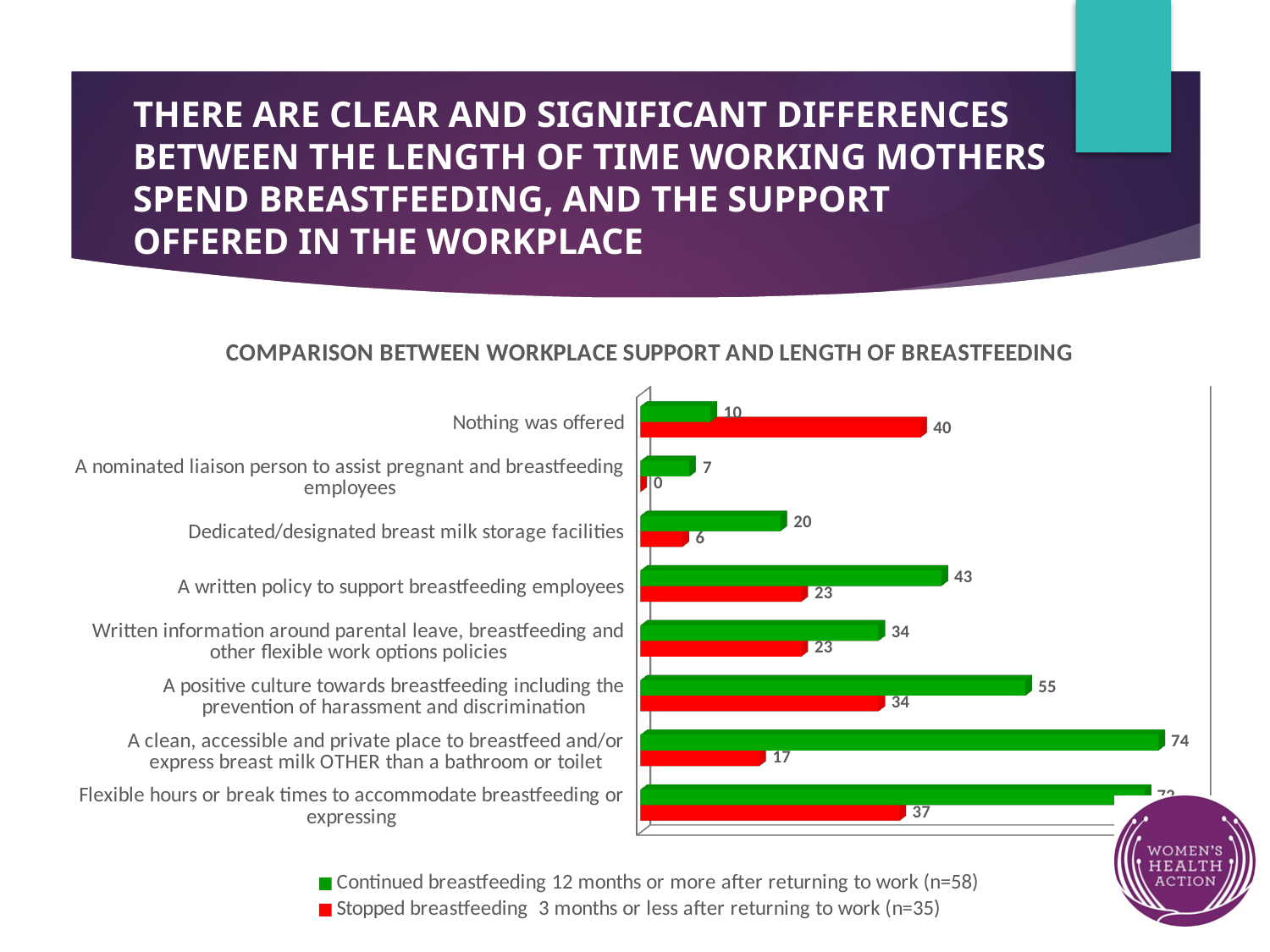
Which category has the highest value in the 'Stopped breastfeeding 3 months or less after returning to work' series? Nothing was offered How many series does the legend list? 2 What is the value for 'Dedicated/designated breast milk storage facilities' in the 'Stopped breastfeeding 3 months or less after returning to work' series? 6 What kind of chart is shown on the slide? bar chart How many categories are shown on the chart? 8 What is the difference between the two series for 'A written policy to support breastfeeding employees'? 20 What is the value for 'Nothing was offered' in the 'Stopped breastfeeding 3 months or less after returning to work' series? 40 What is the value for 'A clean, accessible and private place to breastfeed and/or express breast milk OTHER than a bathroom or toilet' in the 'Continued breastfeeding 12 months or more after returning to work' series? 74 What is the difference between the two series for 'A positive culture towards breastfeeding including the prevention of harassment and discrimination'? 21 For 'Nothing was offered', which series has the larger value? Stopped breastfeeding 3 months or less after returning to work (n=35) What is the title of the chart? COMPARISON BETWEEN WORKPLACE SUPPORT AND LENGTH OF BREASTFEEDING Which category has the lowest value in the 'Stopped breastfeeding 3 months or less after returning to work' series? A nominated liaison person to assist pregnant and breastfeeding employees